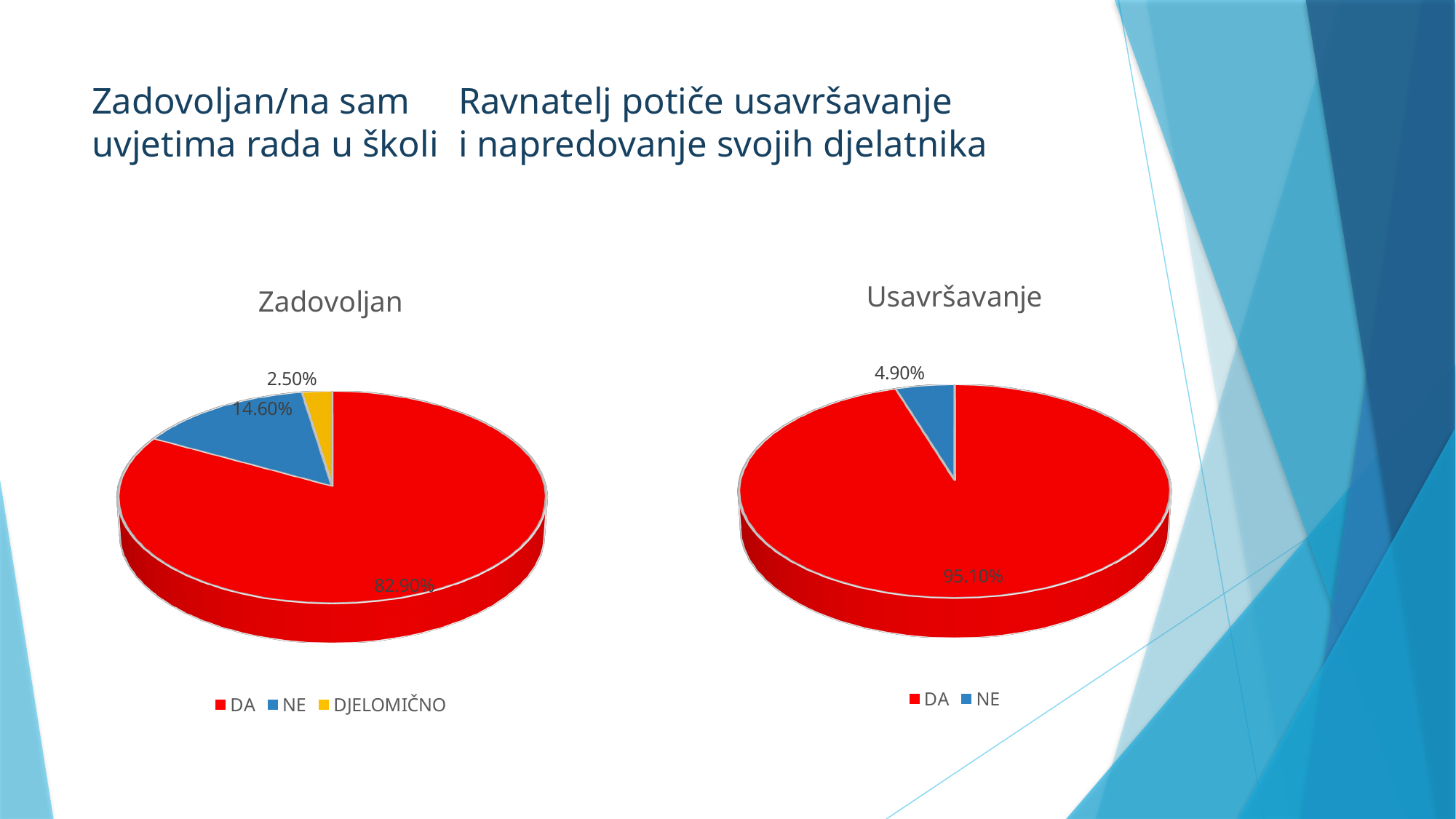
In the "Zadovoljan" chart, what is the difference between the NE and DJELOMIČNO values? 12.10% In the "Usavršavanje" chart, what share of the pie is DA? 95.10% In the "Zadovoljan" chart, what is the value for NE? 14.60% In the "Zadovoljan" chart, what share of the pie is DA? 82.90% In the "Usavršavanje" chart, what is the value for NE? 4.90% What kind of chart is the "Usavršavanje" chart? Pie chart How many categories does the "Zadovoljan" chart show? 3 In the "Zadovoljan" chart, which category has the smallest slice? DJELOMIČNO In the "Zadovoljan" chart, what colour is the DJELOMIČNO slice? Yellow In the "Usavršavanje" chart, which is larger, DA or NE? DA In the "Zadovoljan" chart, what is the value for DJELOMIČNO? 2.50% In the "Zadovoljan" chart, which category has the largest slice? DA